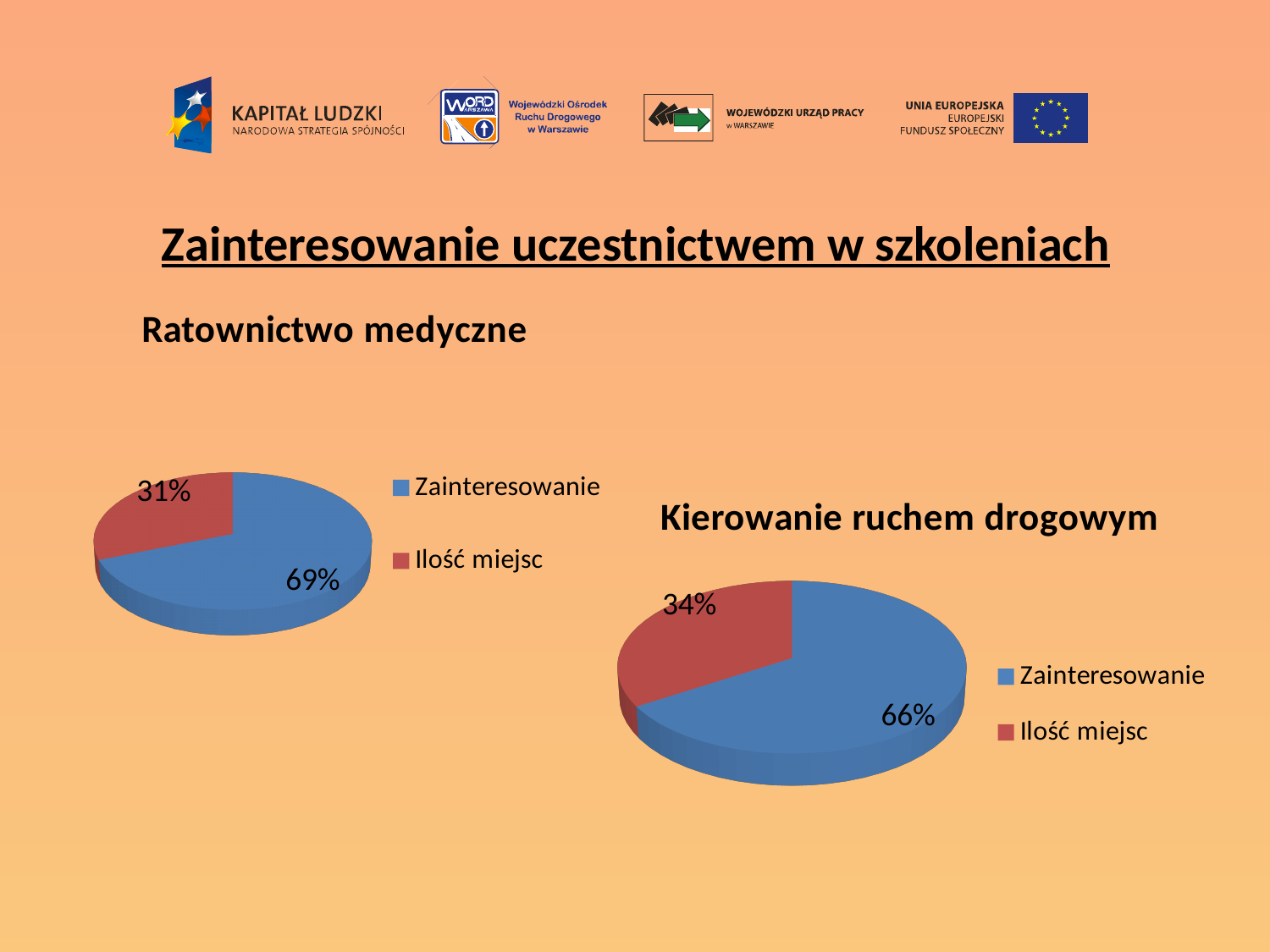
In the 'Kierowanie ruchem drogowym' chart, what share does 'Ilość miejsc' have? 34% In the 'Kierowanie ruchem drogowym' chart, which slice is the smallest? Ilość miejsc In the 'Kierowanie ruchem drogowym' chart, which is larger: 'Zainteresowanie' or 'Ilość miejsc'? Zainteresowanie How many slices does the 'Kierowanie ruchem drogowym' pie chart have? 2 In the 'Ratownictwo medyczne' chart, what colour is the 'Ilość miejsc' slice? Red In the 'Ratownictwo medyczne' chart, what share does 'Ilość miejsc' have? 31% In the 'Ratownictwo medyczne' chart, which slice is the largest? Zainteresowanie In the 'Kierowanie ruchem drogowym' chart, what share does 'Zainteresowanie' have? 66% In the 'Ratownictwo medyczne' chart, what is the difference between the 'Zainteresowanie' and 'Ilość miejsc' shares? 38% In the 'Kierowanie ruchem drogowym' chart, what is the difference between the 'Zainteresowanie' and 'Ilość miejsc' shares? 32% What type of chart is the 'Ratownictwo medyczne' chart? Pie chart